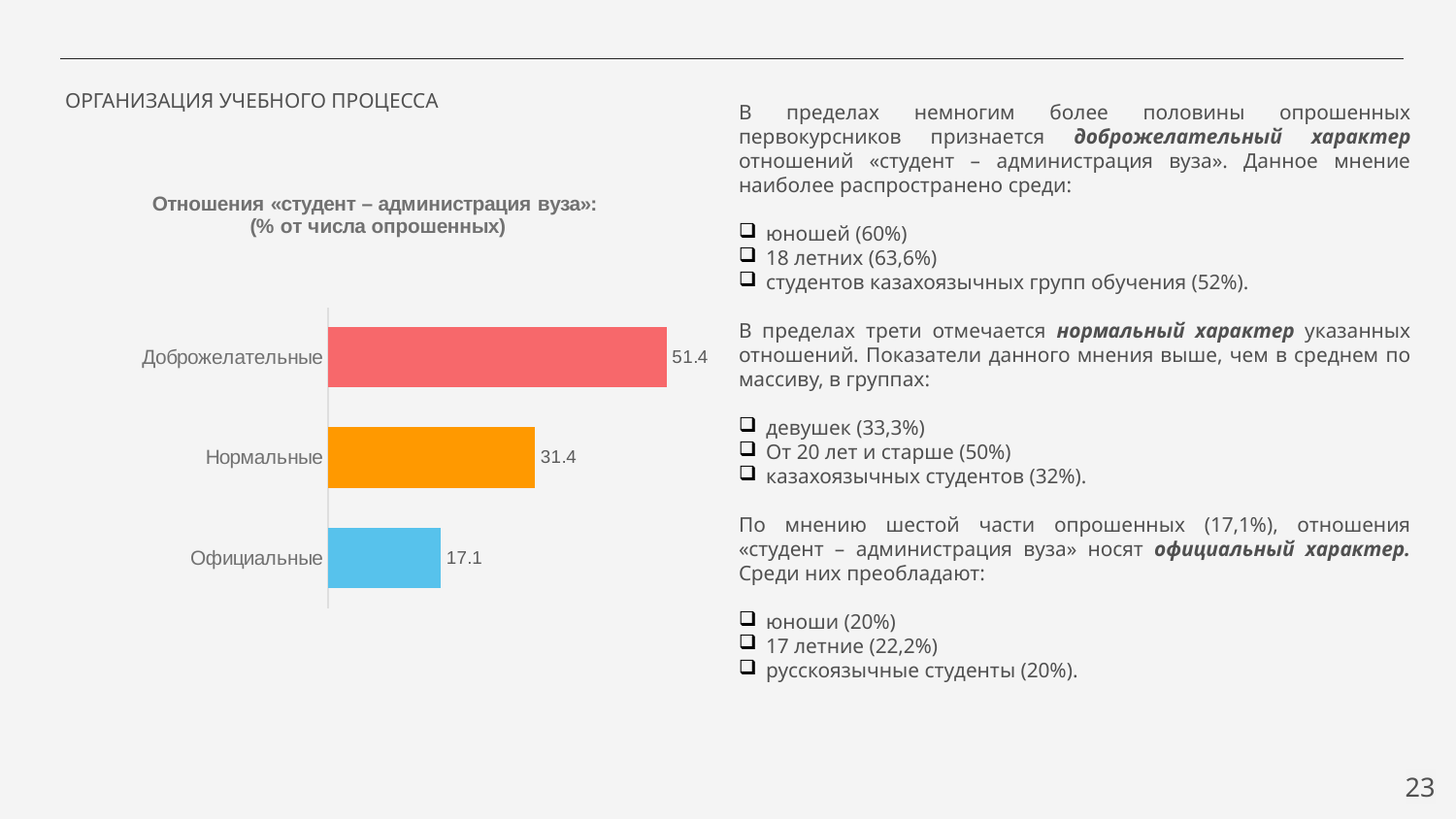
What is the difference between the values for Нормальные and Официальные? 14.3 What is the value for Доброжелательные? 51.4 What colour is the bar for Нормальные? orange Which category has the highest value? Доброжелательные What kind of chart is shown on the slide? bar chart What is the value for Нормальные? 31.4 Which category has the lowest value? Официальные What is the title of the chart? Отношения «студент – администрация вуза»: (% от числа опрошенных) Which is larger, the value for Нормальные or the value for Официальные? Нормальные What is the value for Официальные? 17.1 What is the difference between the values for Доброжелательные and Нормальные? 20 How many categories are shown in the chart? 3